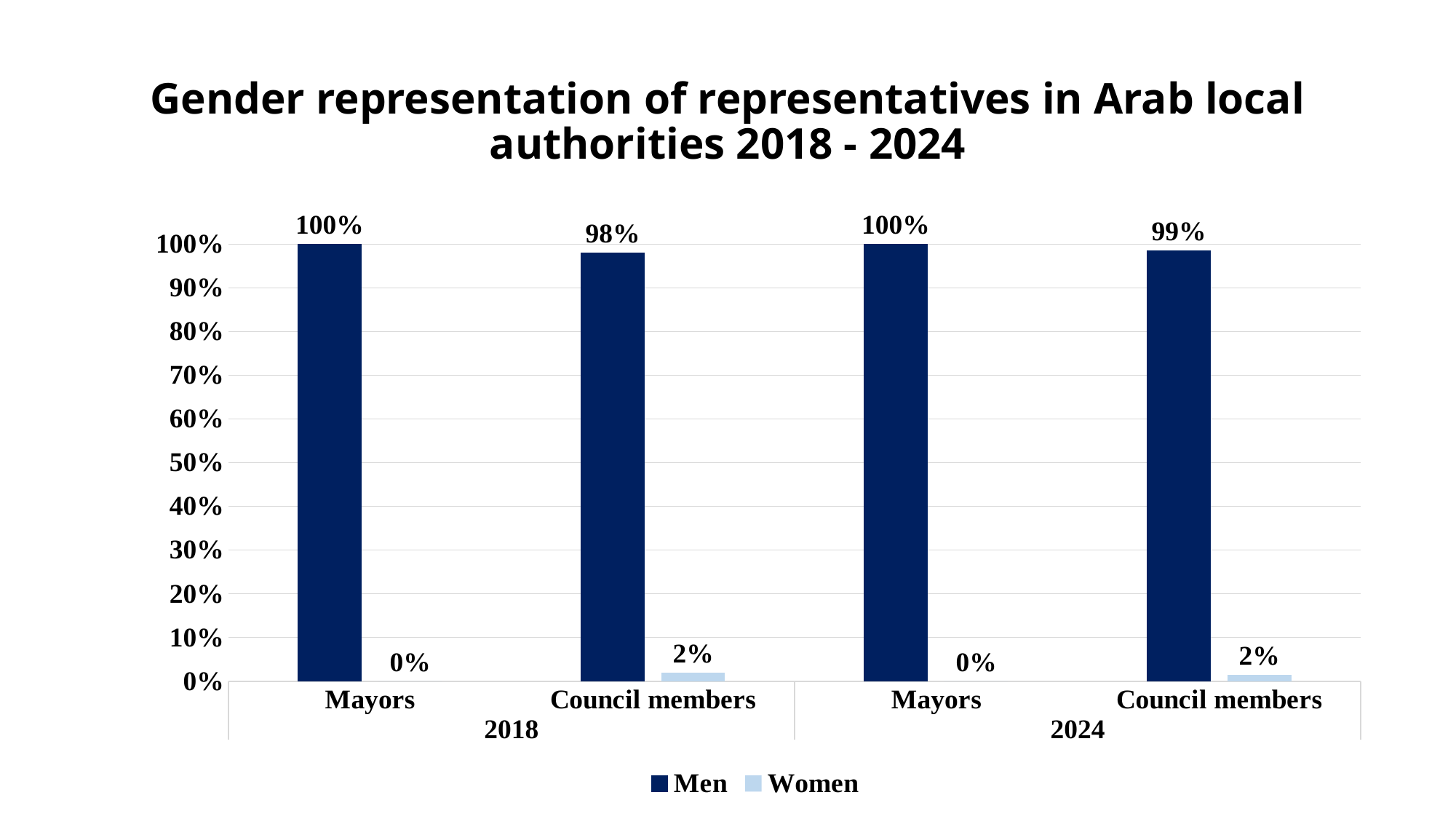
What percentage of mayors in 2018 were men? 100% Which category has the lowest Men value? Council members in 2018 What is the title of the chart? Gender representation of representatives in Arab local authorities 2018 - 2024 What is the difference between the Men and Women values for council members in 2018? 96% What percentage of mayors in 2024 were women? 0% What kind of chart is shown on the slide? Bar chart What percentage of council members in 2024 were men? 99% How many categories are shown along the x axis? 4 Which is larger: the Men value for council members in 2018 or the Men value for council members in 2024? Council members in 2024 What percentage of council members in 2018 were women? 2% How many series does the legend list? 2 Which series is shown in dark blue? Men